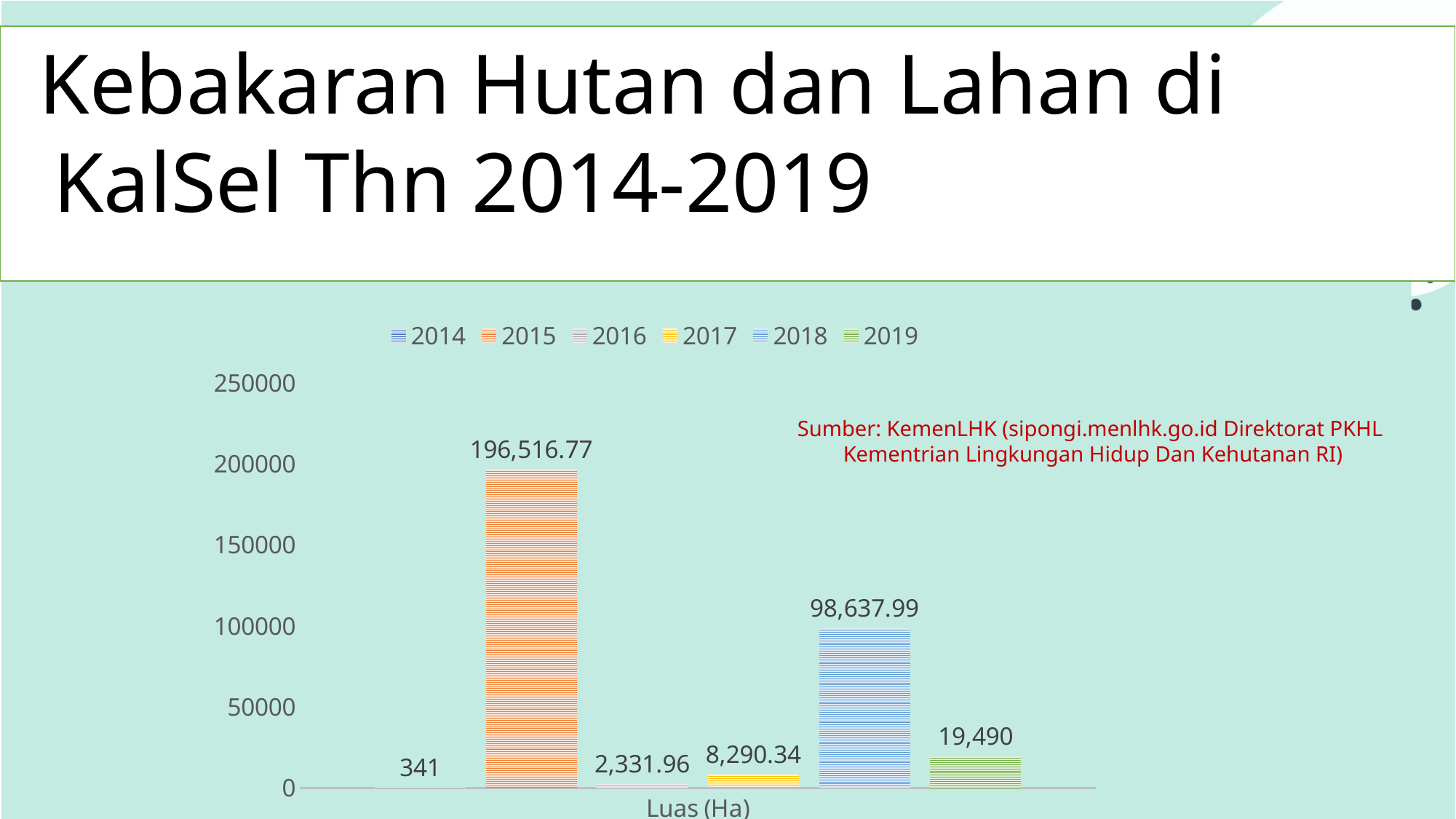
What is the value for 2019 in the chart? 19,490 Is the value for 2018 greater or less than 50000? greater What is the difference between the values for 2015 and 2018? 97,878.78 Which year has the lowest value in the chart? 2014 How many series does the legend list? 6 What kind of chart is shown on the slide? bar chart Which is larger, the value for 2017 or the value for 2016? 2017 What is the difference between the values for 2019 and 2017? 11,199.66 What is the value for 2014 in the chart? 341 What is the value for 2018 in the chart? 98,637.99 What is the value for 2015 in the chart? 196,516.77 Which year has the highest value in the chart? 2015